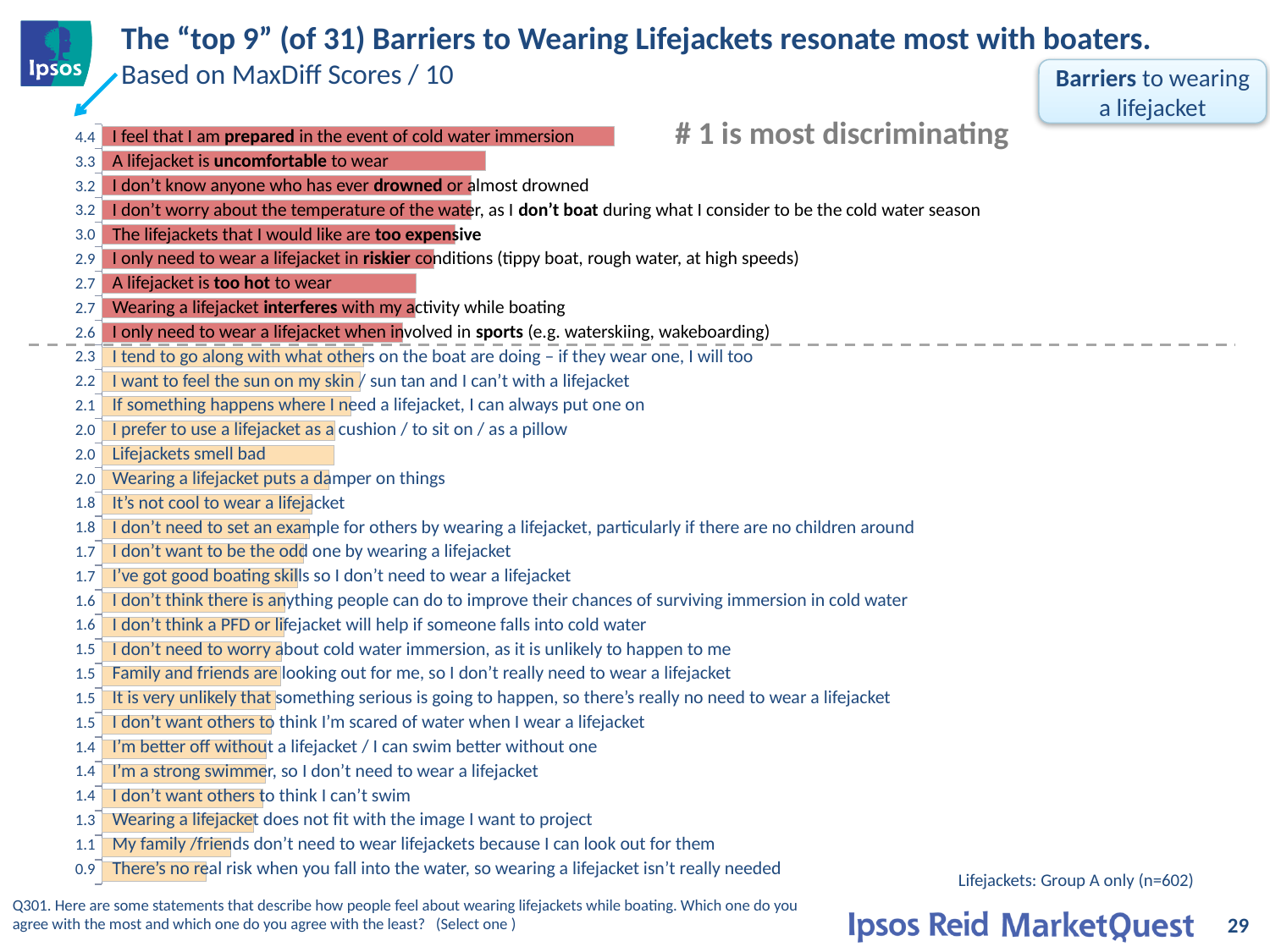
What is the MaxDiff score for "The lifejackets that I would like are too expensive"? 3.0 What is the MaxDiff score for "I'm a strong swimmer, so I don't need to wear a lifejacket"? 1.4 What is the MaxDiff score for "Lifejackets smell bad"? 2.0 Which has a higher score: "A lifejacket is too hot to wear" or "It's not cool to wear a lifejacket"? A lifejacket is too hot to wear Which barrier has the lowest MaxDiff score? There's no real risk when you fall into the water, so wearing a lifejacket isn't really needed Do the MaxDiff scores increase or decrease going from the top bar to the bottom bar? Decrease What is the difference between the score for "The lifejackets that I would like are too expensive" and the score for "There's no real risk when you fall into the water, so wearing a lifejacket isn't really needed"? 2.1 What is the MaxDiff score for "A lifejacket is uncomfortable to wear"? 3.3 Which barrier has the highest MaxDiff score? I feel that I am prepared in the event of cold water immersion How many barrier statements are plotted in the chart? 31 What is the difference between the score for "I feel that I am prepared in the event of cold water immersion" and the score for "A lifejacket is uncomfortable to wear"? 1.1 What kind of chart is shown on the slide? Bar chart